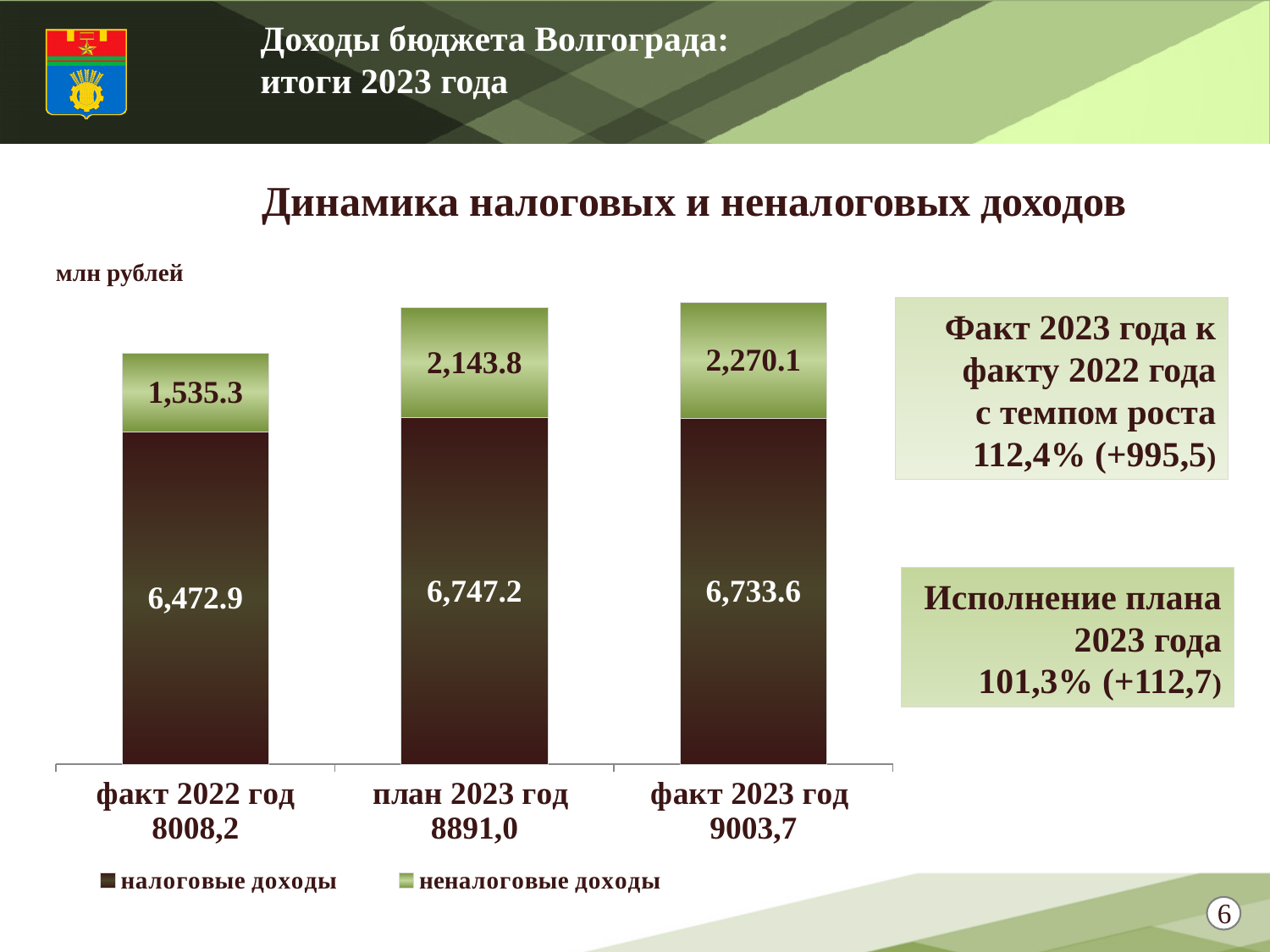
What kind of chart is shown on the slide? stacked bar chart Which category has the lowest value of налоговые доходы? факт 2022 год Which category has the highest value of неналоговые доходы? факт 2023 год What is the difference between неналоговые доходы for факт 2023 год and план 2023 год? 126.3 What is the value of налоговые доходы for факт 2022 год? 6,472.9 What is the difference between налоговые доходы for план 2023 год and факт 2022 год? 274.3 What is the value of неналоговые доходы for факт 2023 год? 2,270.1 How many series does the legend list? 2 How many categories are shown on the x axis? 3 What is the value of налоговые доходы for план 2023 год? 6,747.2 What is the total of the stacked bar for факт 2023 год? 9003,7 Which is larger: налоговые доходы for план 2023 год or for факт 2023 год? план 2023 год